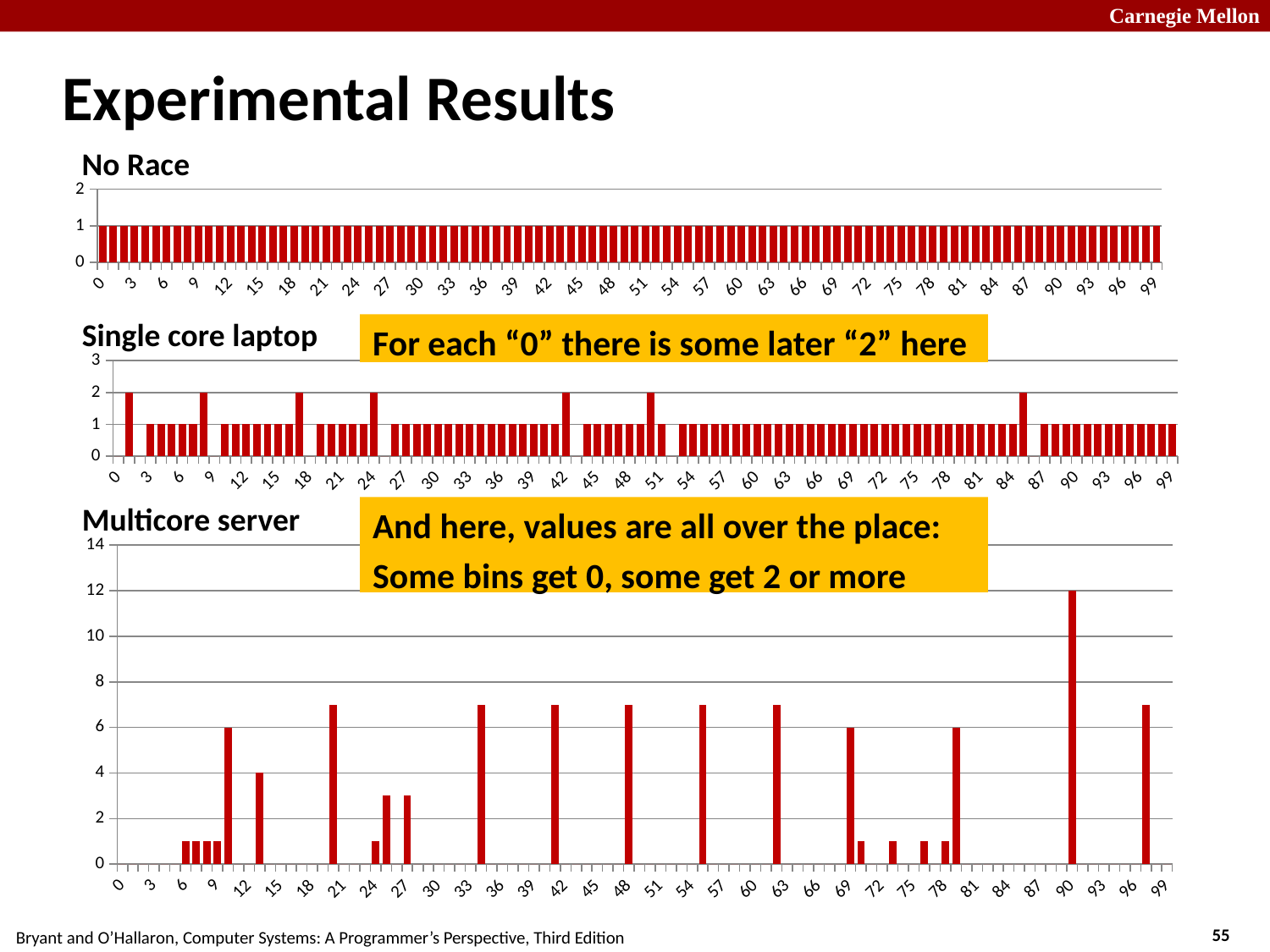
How many charts are shown on the slide? 3 Which chart has the taller maximum bar, "Single core laptop" or "Multicore server"? Multicore server What kind of chart is the "No Race" chart at the top of the slide? bar chart In the "Multicore server" chart, what is the value plotted for category 0? 0 In the "Multicore server" chart, is the tallest bar greater or less than 10? greater In the "No Race" chart, what is the highest value any bar reaches? 1 In the "No Race" chart, do the values rise, fall, or stay constant across the x axis? stay constant In the "Single core laptop" chart, what is the highest value any bar reaches? 2 In the "Single core laptop" chart, what is the lowest value plotted? 0 In the "No Race" chart, what is the value plotted for category 50? 1 In the "Multicore server" chart, which category has the tallest bar? 90